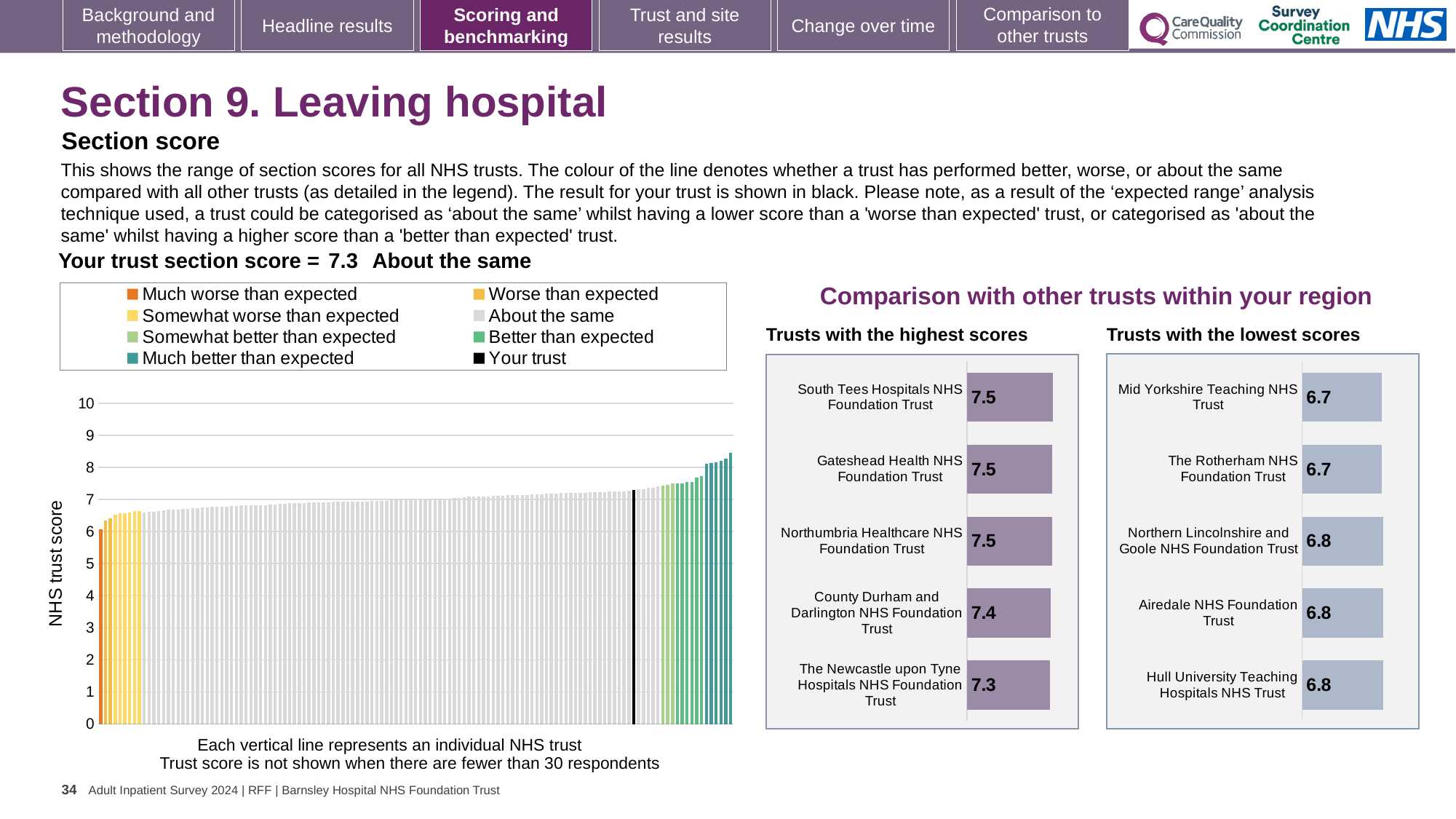
In the 'Trusts with the highest scores' chart, what is the score for South Tees Hospitals NHS Foundation Trust? 7.5 In the 'Trusts with the highest scores' chart, which trust has the lowest score? The Newcastle upon Tyne Hospitals NHS Foundation Trust In the 'Trusts with the highest scores' chart, what is the difference between the scores of South Tees Hospitals NHS Foundation Trust and The Newcastle upon Tyne Hospitals NHS Foundation Trust? 0.2 How many entries does the legend of the large chart on the left list? 8 What kind of chart is the large chart on the left showing NHS trust scores? Bar chart How many trusts are shown in the 'Trusts with the highest scores' chart? 5 In the 'Trusts with the highest scores' chart, what is the score for County Durham and Darlington NHS Foundation Trust? 7.4 In the 'Trusts with the lowest scores' chart, what is the score for Mid Yorkshire Teaching NHS Trust? 6.7 In the 'Trusts with the lowest scores' chart, which is larger: the score for Northern Lincolnshire and Goole NHS Foundation Trust or The Rotherham NHS Foundation Trust? Northern Lincolnshire and Goole NHS Foundation Trust In the 'Trusts with the lowest scores' chart, what is the score for Hull University Teaching Hospitals NHS Trust? 6.8 In the 'Trusts with the lowest scores' chart, what is the difference between the scores of Airedale NHS Foundation Trust and The Rotherham NHS Foundation Trust? 0.1 In the large chart on the left, is the value for the black 'Your trust' bar greater or less than 7? greater